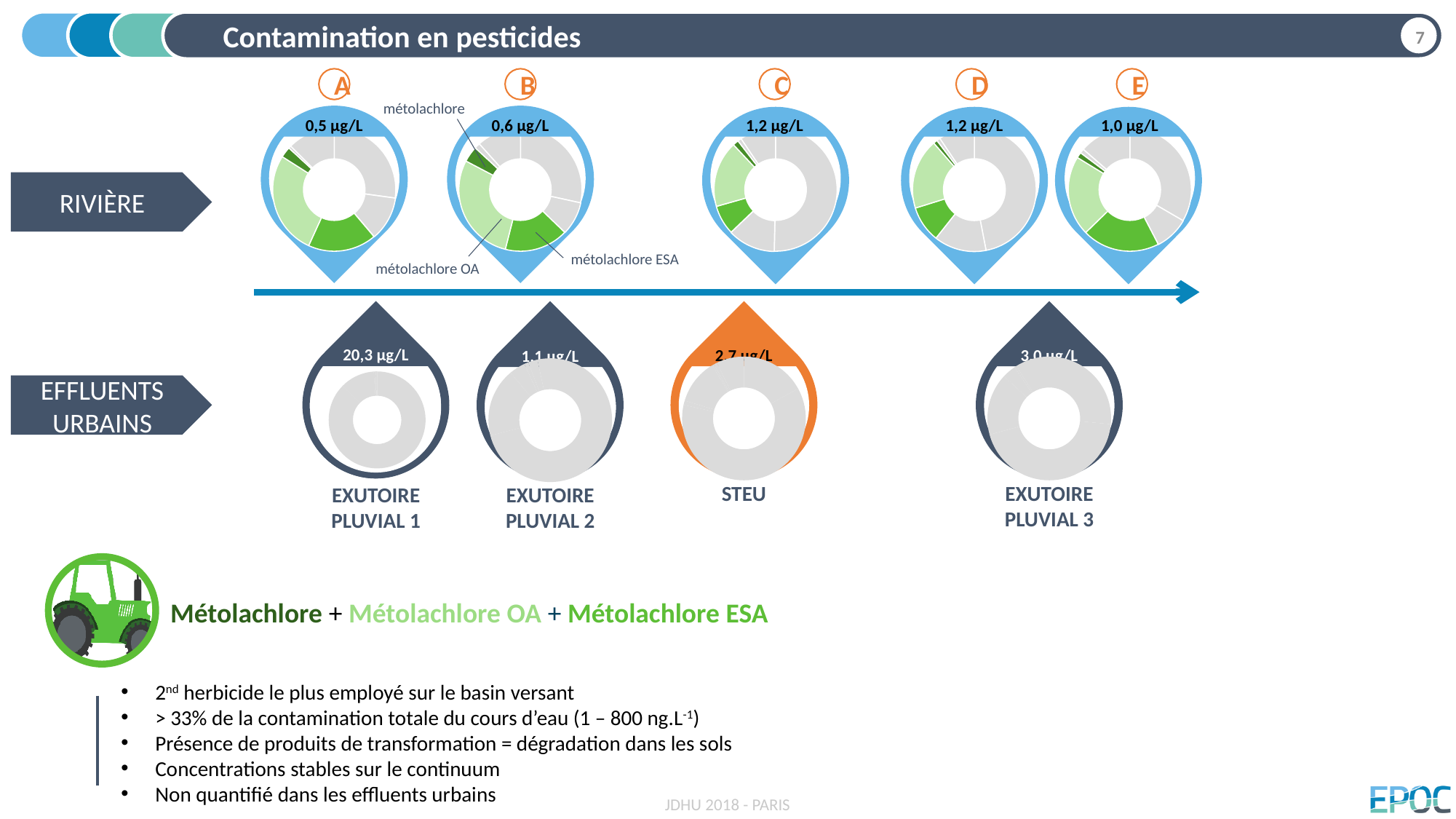
Among the urban effluent charts, which one has the lowest printed concentration? EXUTOIRE PLUVIAL 2 What total concentration is printed above the river donut chart for site E? 1,0 µg/L How many river sites (donut charts in the RIVIÈRE row) are shown? 5 Which has the larger printed concentration, river site C or river site A? Site C What is the difference between the printed concentrations of EXUTOIRE PLUVIAL 1 and EXUTOIRE PLUVIAL 3? 17,3 µg/L Among the urban effluent charts, which one has the highest printed concentration? EXUTOIRE PLUVIAL 1 How many compounds does the legend at the bottom list for the donut charts? 3 What total concentration is printed above the river donut chart for site C? 1,2 µg/L Among the river sites A to E, which site has the lowest printed concentration? A In the EFFLUENTS URBAINS row, what concentration is printed for EXUTOIRE PLUVIAL 1? 20,3 µg/L In the EFFLUENTS URBAINS row, what concentration is printed for STEU? 2,7 µg/L What total concentration is printed above the river donut chart for site A? 0,5 µg/L